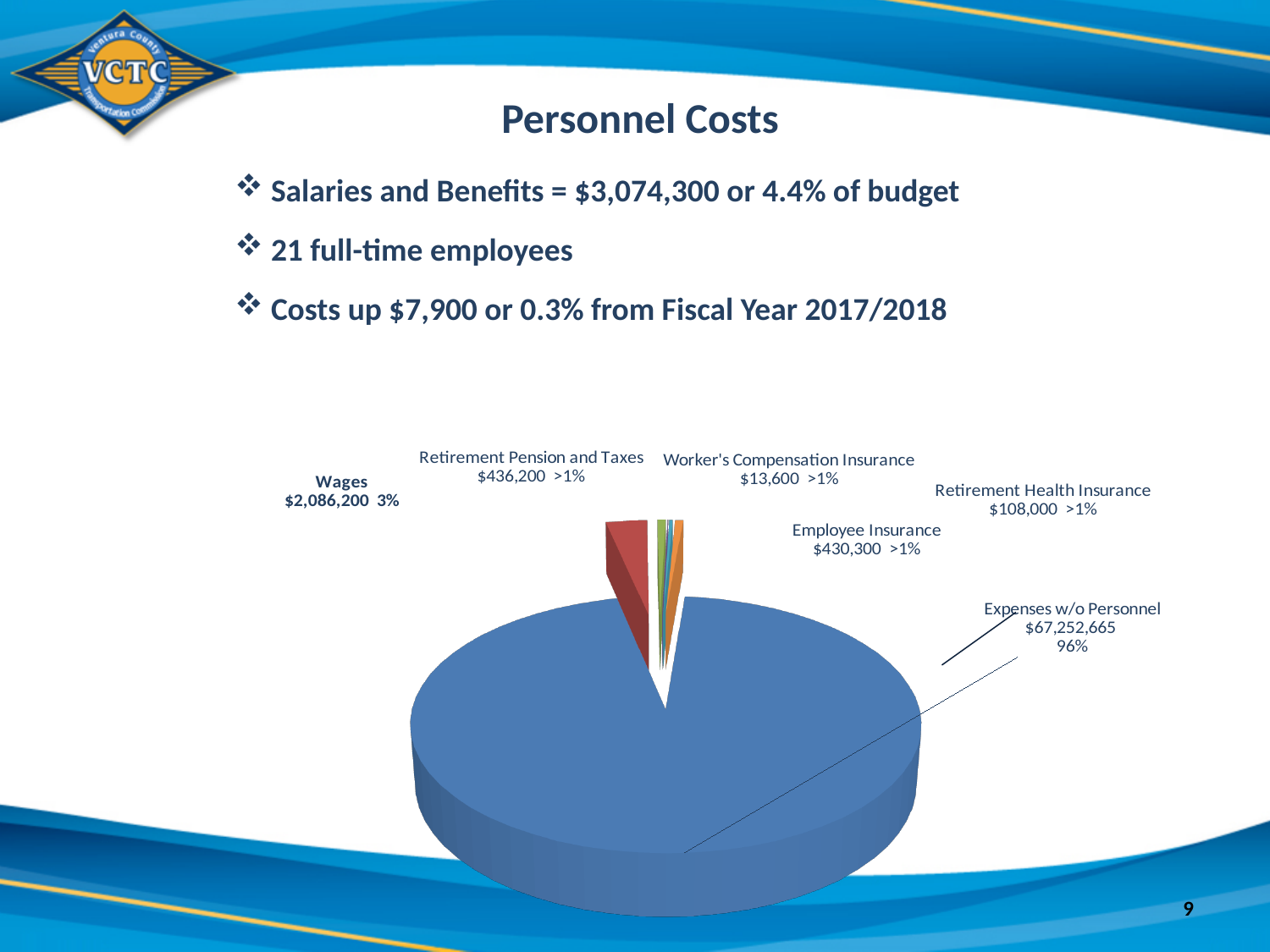
Which is larger, the value for Retirement Pension and Taxes or the value for Employee Insurance? Retirement Pension and Taxes What share of the pie does Expenses w/o Personnel represent? 96% What is the difference between the Employee Insurance value and the Retirement Health Insurance value? $322,300 What is the value shown for Expenses w/o Personnel in the pie chart? $67,252,665 What is the value shown for Wages in the pie chart? $2,086,200 What is the value shown for Retirement Health Insurance in the pie chart? $108,000 Which category has the largest slice in the pie chart? Expenses w/o Personnel How many slices does the pie chart have? 6 Which category has the smallest slice in the pie chart? Worker's Compensation Insurance What is the value shown for Worker's Compensation Insurance in the pie chart? $13,600 What kind of chart is shown on the slide? Pie chart What is the difference between the Wages value and the Retirement Pension and Taxes value? $1,650,000